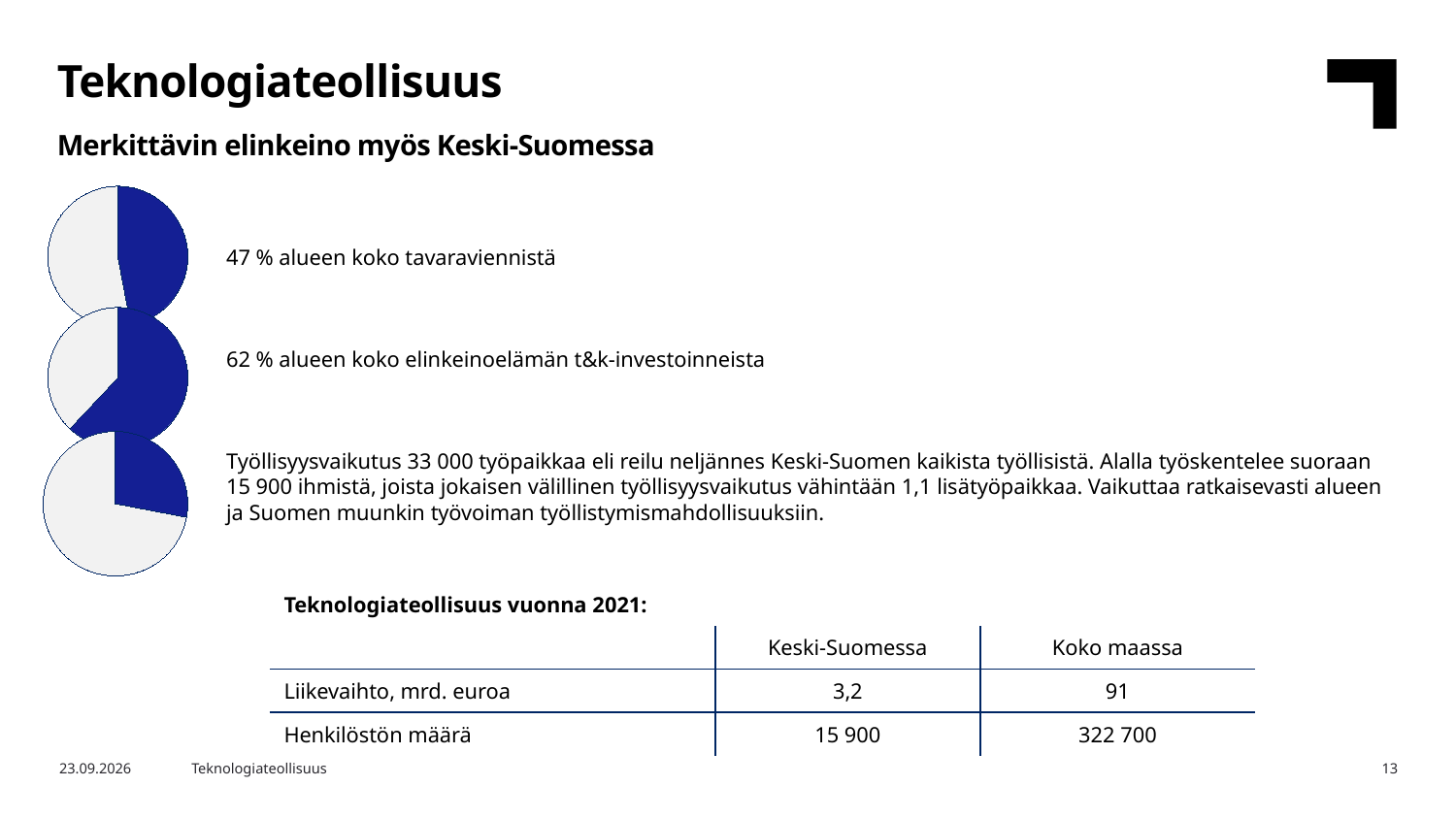
In the middle pie chart, what share of the region's business R&D investments (t&k-investoinnit) does the blue slice represent? 62 % Is the blue slice in the bottom pie chart greater or less than half of the pie? less What colour is used for the highlighted slice in the pie charts? Blue How many pie charts are on the slide? 3 Which of the three pie charts has the largest blue slice? The middle pie chart (62 %) Is the blue slice in the middle pie chart greater or less than half of the pie? greater In the top pie chart, what share of the region's total goods exports (tavaravienti) does the blue slice represent? 47 % Which of the three pie charts has the smallest blue slice? The bottom pie chart What is the difference in percentage points between the blue share of the middle pie chart and the blue share of the top pie chart? 15 percentage points What kind of charts are shown on the left side of the slide? Pie charts Which is larger: the blue share in the top pie chart (goods exports) or in the middle pie chart (R&D investments)? The middle pie chart (R&D investments) How many slices does each pie chart have? 2